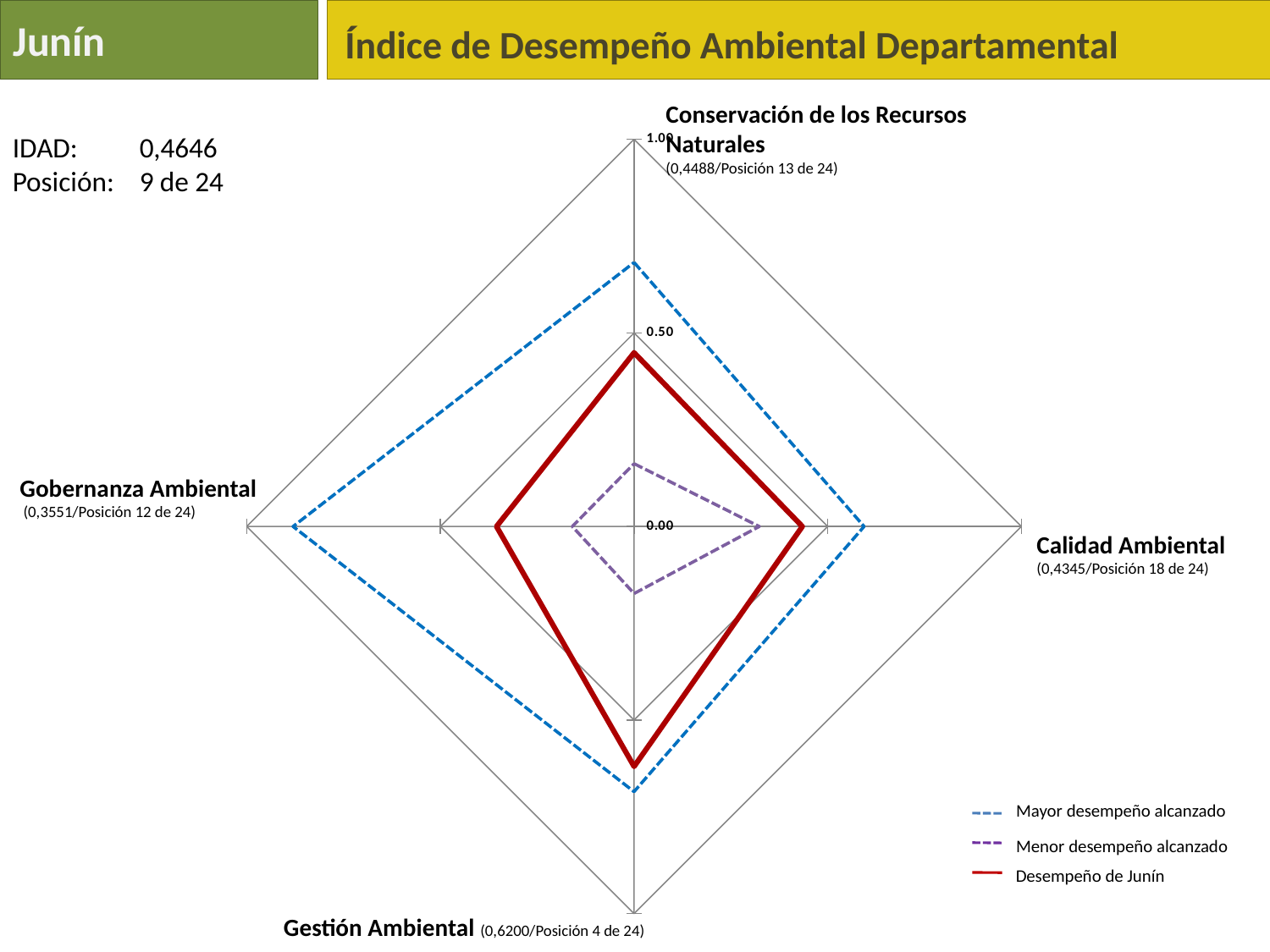
What is Junín's value for Conservación de los Recursos Naturales? 0,4488 What is the difference between Junín's Gestión Ambiental value and its Gobernanza Ambiental value? 0,2649 What is Junín's value for Gestión Ambiental? 0,6200 Which series is drawn as a solid red line? Desempeño de Junín How many series does the legend list? 3 What is Junín's value for Calidad Ambiental? 0,4345 On which axis does Junín have its lowest value? Gobernanza Ambiental How many axes (categories) does the radar chart have? 4 On which axis does Junín have its highest value? Gestión Ambiental Is Junín's value for Gestión Ambiental greater or less than 0.50? greater What is Junín's value for Gobernanza Ambiental? 0,3551 What kind of chart is shown on the slide? radar chart